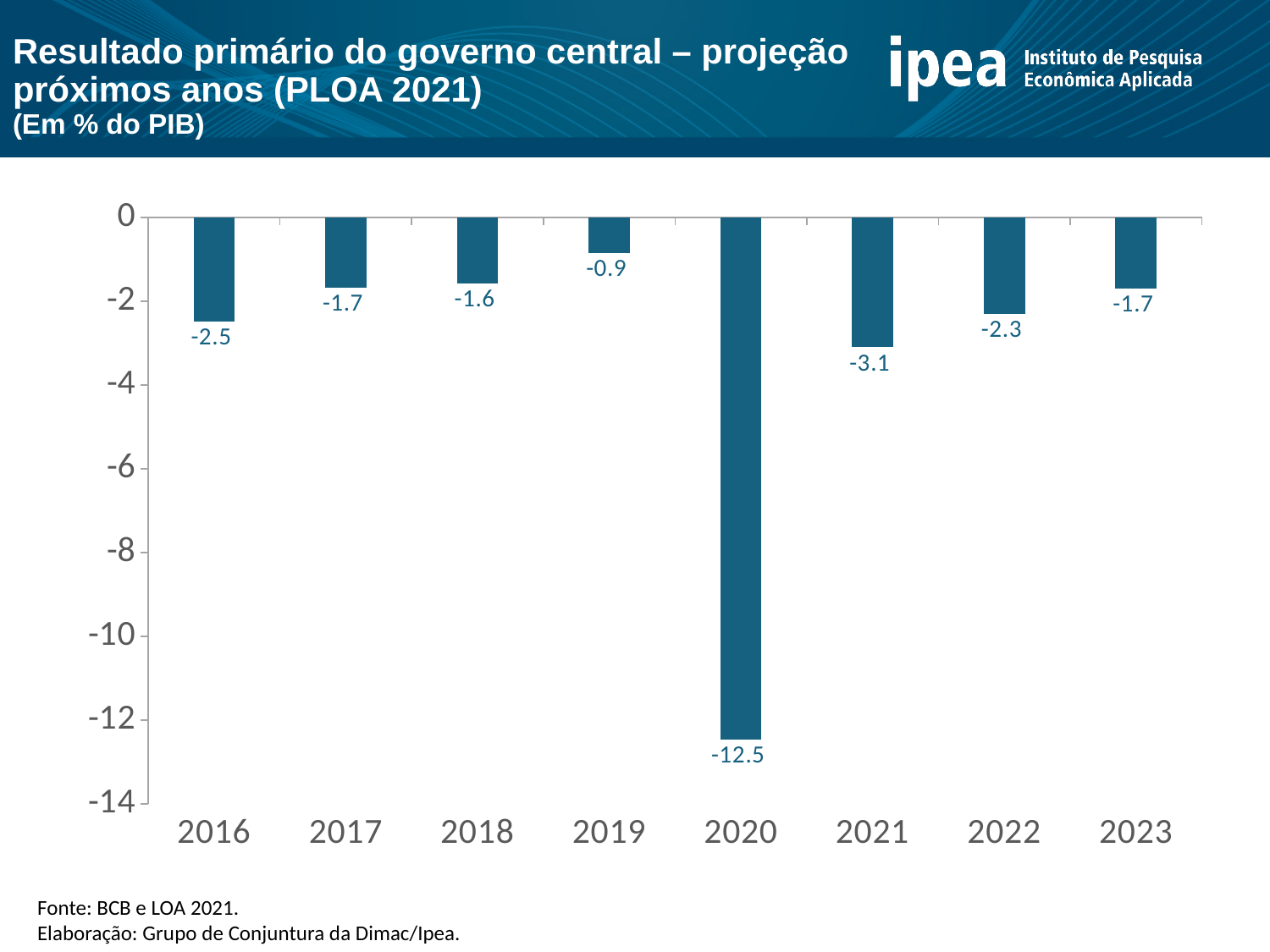
Which year has the highest (least negative) value? 2019 What is the difference between the values for 2021 and 2022? 0.8 Which year has the lowest (most negative) value? 2020 What is the value for 2019? -0.9 How many years are shown on the x axis? 8 What is the value for 2016? -2.5 Which year has the higher value, 2018 or 2019? 2019 What is the value for 2021? -3.1 What kind of chart is shown on the slide? Bar chart From 2020 to 2023, do the values rise or fall? Rise What is the value for 2020? -12.5 What is the difference between the values for 2020 and 2021? 9.4